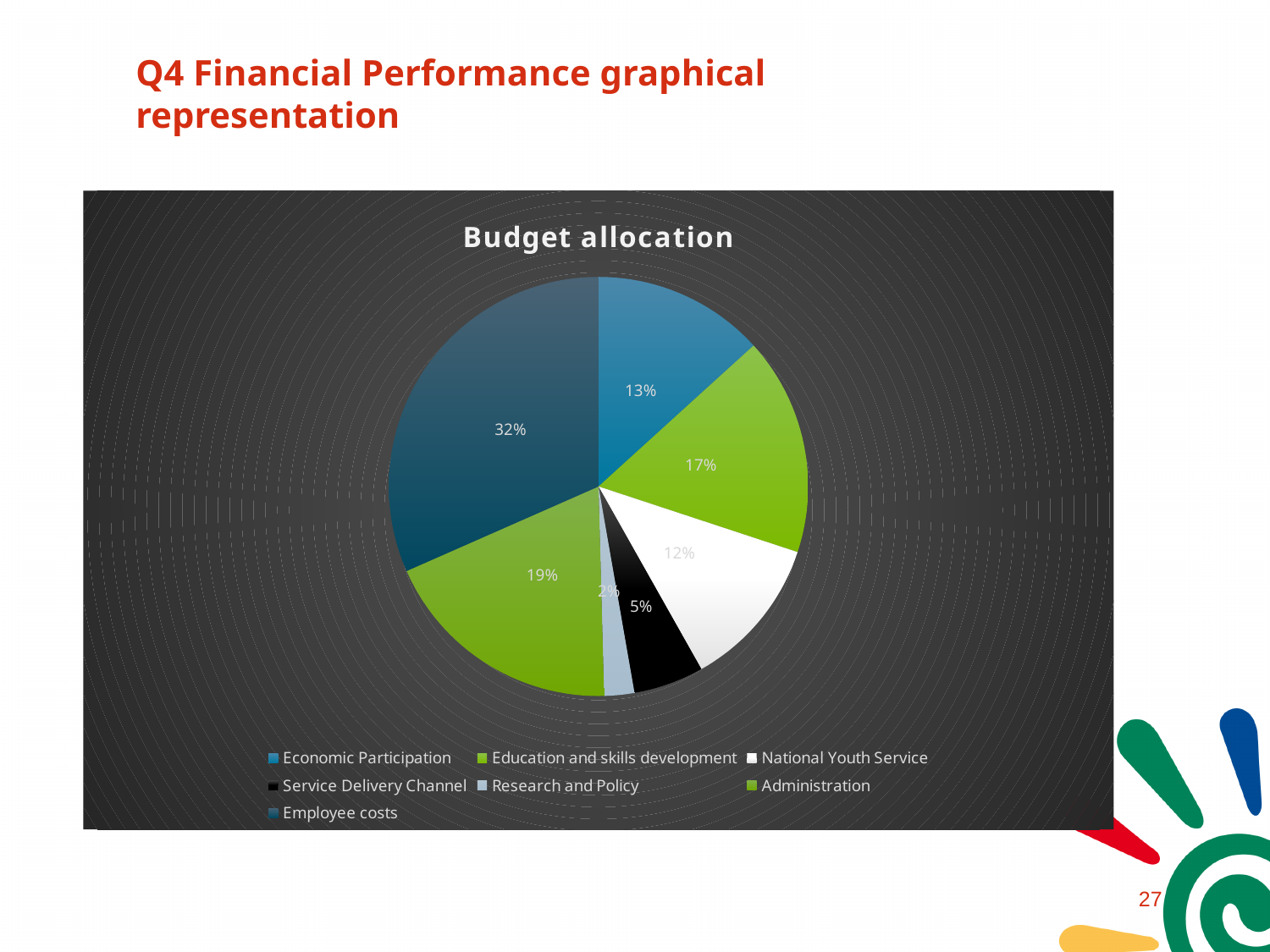
Which category has the largest share of the budget? Employee costs What share of the budget is allocated to Administration? 19% What type of chart is shown on the slide? Pie chart What share of the budget is allocated to National Youth Service? 12% What share of the budget is allocated to Economic Participation? 13% Which category has the smallest share of the budget? Research and Policy How many categories does the pie chart show? 7 What is the title of the chart? Budget allocation What is the difference in percentage points between Employee costs and Administration? 13 Which has a larger share, Education and skills development or Service Delivery Channel? Education and skills development